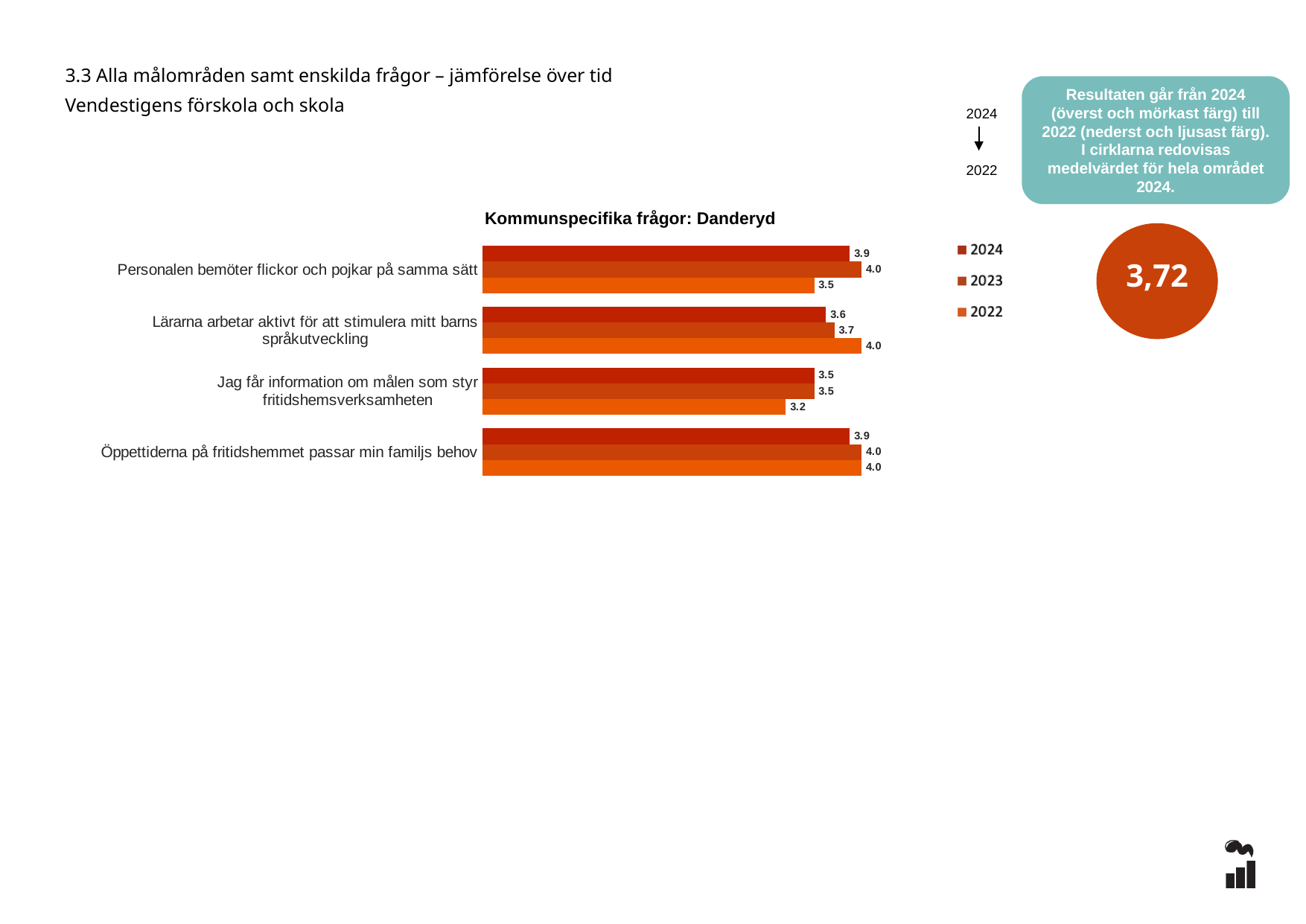
What is the 2022 value for "Lärarna arbetar aktivt för att stimulera mitt barns språkutveckling"? 4.0 What is the difference between the 2023 and 2022 values for "Personalen bemöter flickor och pojkar på samma sätt"? 0.5 Which category has the lowest 2022 value? Jag får information om målen som styr fritidshemsverksamheten What mean value for the whole area in 2024 is shown in the circle next to the chart? 3,72 How many categories (questions) are plotted in the chart? 4 For "Lärarna arbetar aktivt för att stimulera mitt barns språkutveckling", which is larger: the 2024 value or the 2022 value? 2022 How many series does the legend of the chart list? 3 Which category has the lowest 2024 value? Jag får information om målen som styr fritidshemsverksamheten What is the 2024 value for "Personalen bemöter flickor och pojkar på samma sätt"? 3.9 What is the 2022 value for "Öppettiderna på fritidshemmet passar min familjs behov"? 4.0 What is the 2023 value for "Jag får information om målen som styr fritidshemsverksamheten"? 3.5 What type of chart is shown under the title "Kommunspecifika frågor: Danderyd"? Bar chart